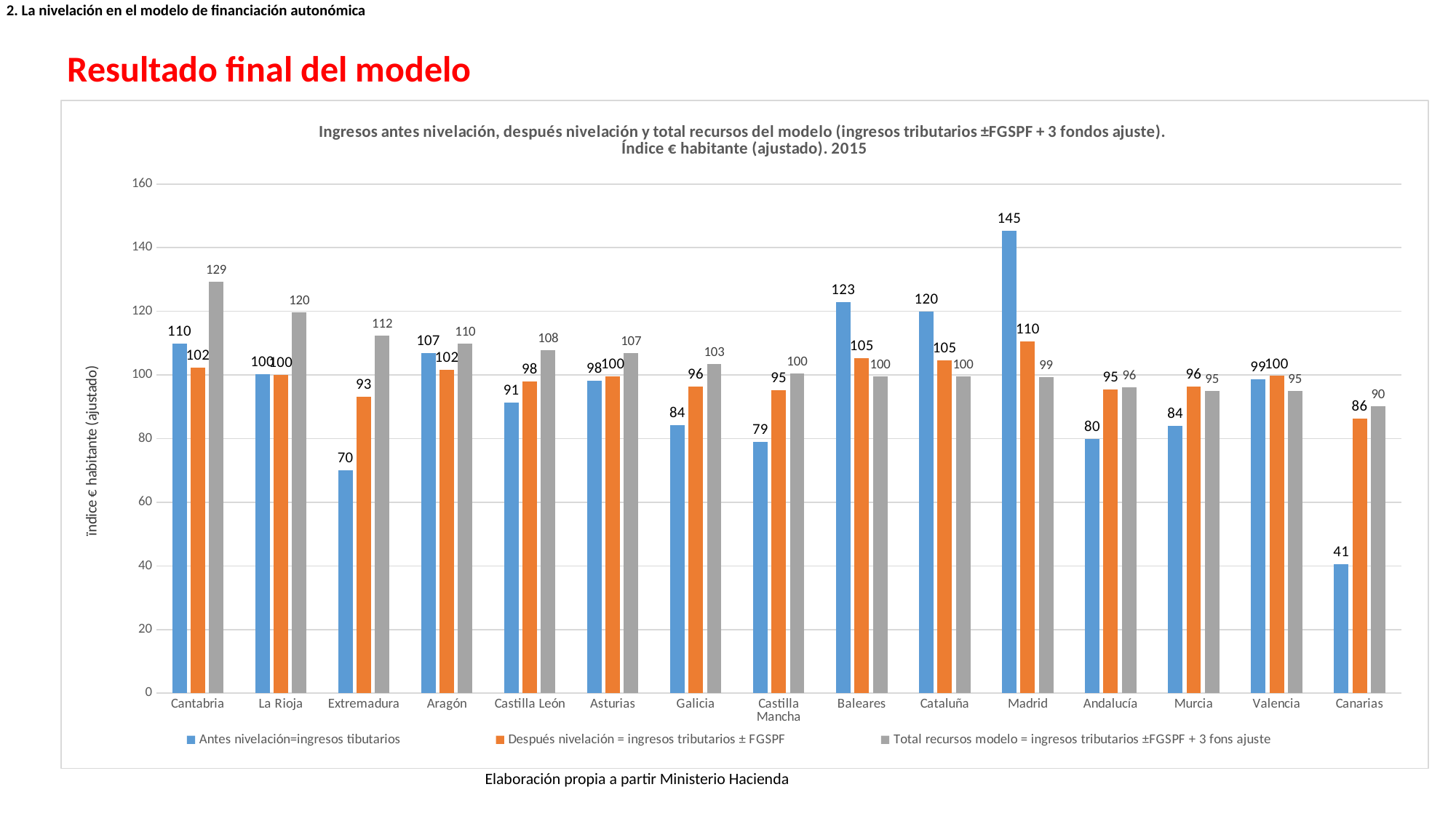
What colour are the 'Después nivelación = ingresos tributarios ± FGSPF' bars? Orange What is the 'Después nivelación' value for Canarias? 86 Is the 'Antes nivelación' value for Extremadura greater or less than 80? less Which is larger for Baleares: the 'Antes nivelación' value or the 'Total recursos modelo' value? Antes nivelación How many series does the legend list? 3 How many regions are shown on the x axis? 15 Which region has the lowest 'Antes nivelación=ingresos tibutarios' value? Canarias Which region has the highest 'Total recursos modelo' value? Cantabria What kind of chart is shown on the slide? Bar chart What is the difference between the 'Antes nivelación' and 'Después nivelación' values for Madrid? 35 What is the 'Antes nivelación=ingresos tibutarios' value for Madrid? 145 What is the 'Total recursos modelo' value for Cantabria? 129